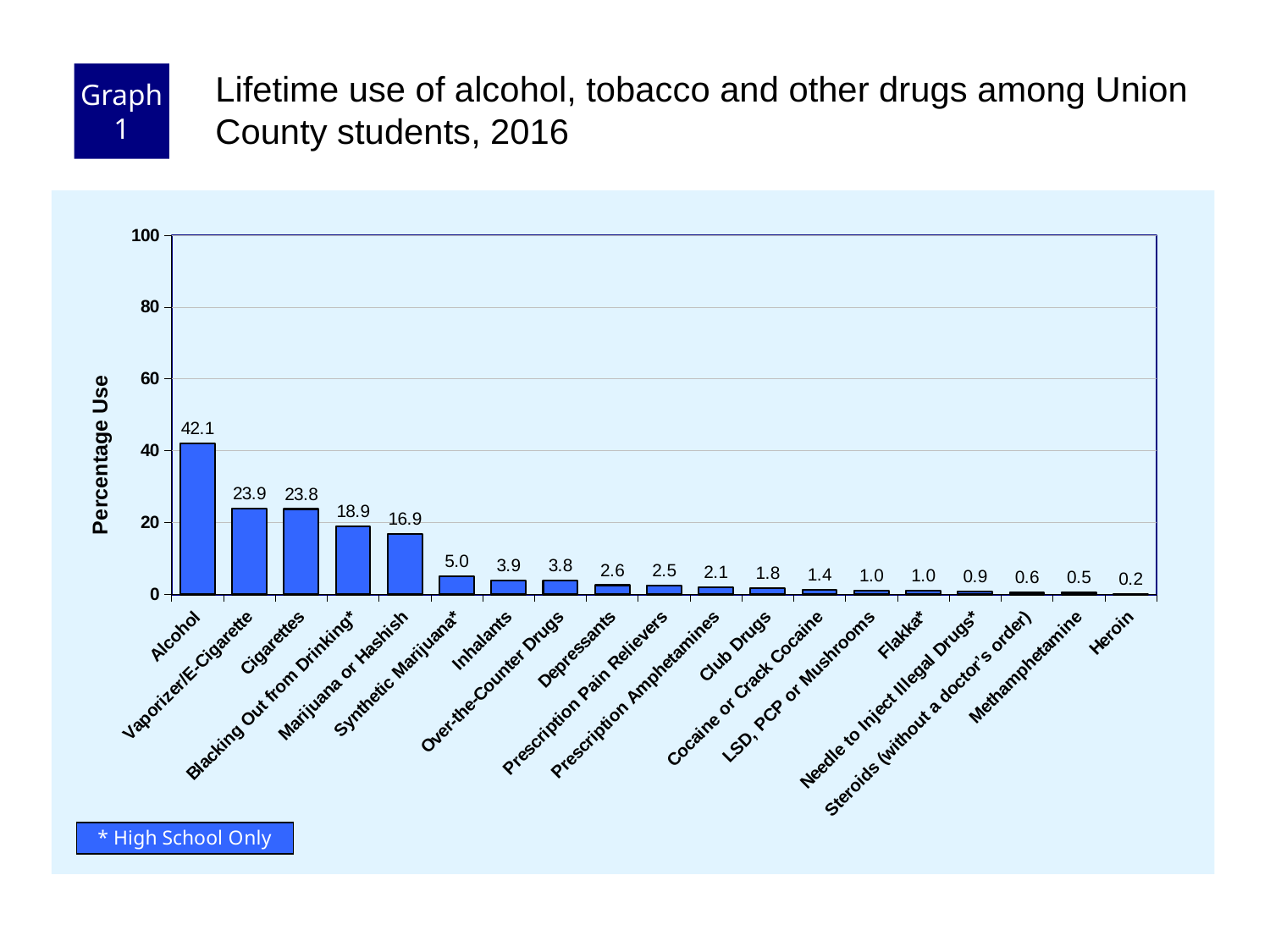
What is the percentage use for Inhalants? 3.9 What is the percentage use for Alcohol? 42.1 What is the percentage use for Marijuana or Hashish? 16.9 Which has a higher percentage use, Club Drugs or Depressants? Depressants What is the difference in percentage use between Blacking Out from Drinking* and Synthetic Marijuana*? 13.9 What is the difference in percentage use between Alcohol and Cigarettes? 18.3 What kind of chart is shown on the slide? Bar chart Which category has the lowest percentage use? Heroin How many categories are shown on the chart? 19 What is the percentage use for Methamphetamine? 0.5 Which category has the highest percentage use? Alcohol Is the value for Vaporizer/E-Cigarette greater or less than 20? greater